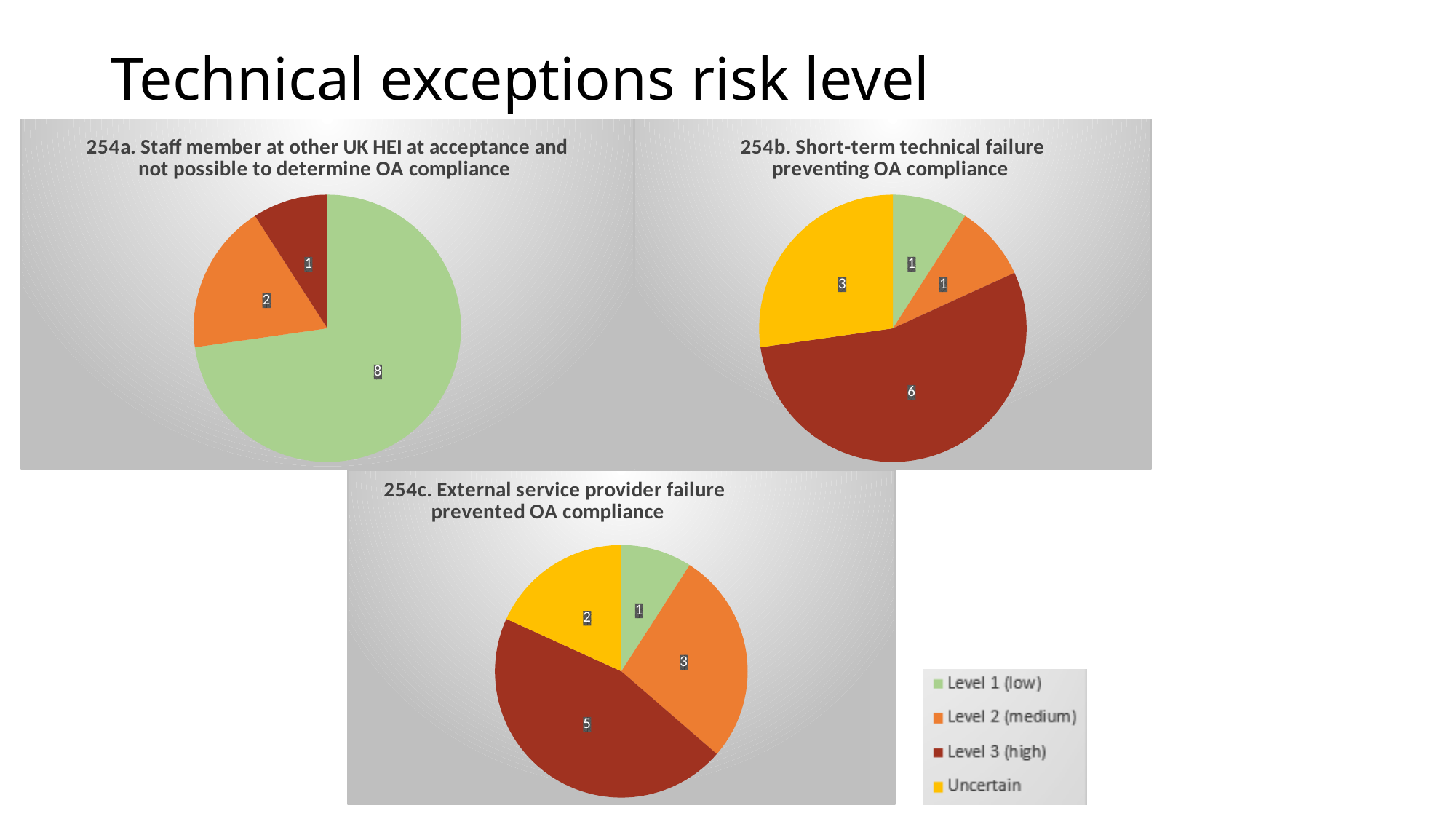
In the chart 254c. External service provider failure prevented OA compliance, which is larger: the Level 3 (high) value or the Uncertain value? Level 3 (high) In the chart 254b. Short-term technical failure preventing OA compliance, what is the value for Level 3 (high)? 6 In the chart 254a. Staff member at other UK HEI at acceptance and not possible to determine OA compliance, which risk level has the largest slice? Level 1 (low) How many slices does the chart 254c. External service provider failure prevented OA compliance have? 4 In the chart 254a. Staff member at other UK HEI at acceptance and not possible to determine OA compliance, what is the value for Level 2 (medium)? 2 In the chart 254c. External service provider failure prevented OA compliance, what is the value for Level 2 (medium)? 3 In the chart 254a. Staff member at other UK HEI at acceptance and not possible to determine OA compliance, what is the value for Level 1 (low)? 8 How many entries does the legend on the slide list? 4 In the chart 254b. Short-term technical failure preventing OA compliance, what is the value for Uncertain? 3 What kind of chart is used for 254a. Staff member at other UK HEI at acceptance and not possible to determine OA compliance? Pie chart In the chart 254c. External service provider failure prevented OA compliance, which risk level has the largest slice? Level 3 (high) In the chart 254b. Short-term technical failure preventing OA compliance, what is the difference between the Level 3 (high) value and the Uncertain value? 3